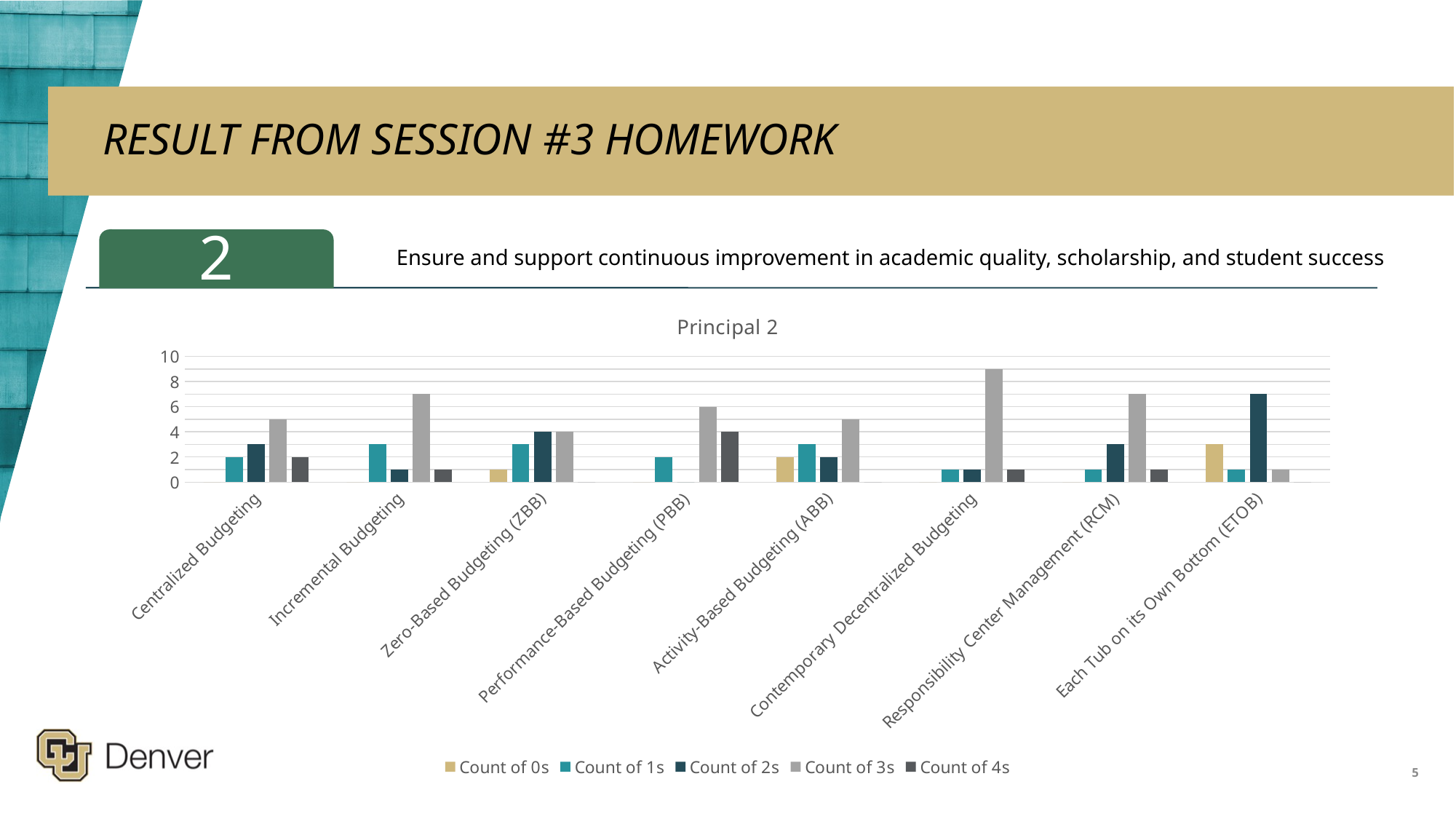
What kind of chart is shown on the slide? bar chart Is the Count of 3s value for Contemporary Decentralized Budgeting greater or less than 8? greater What is the Count of 1s value for Centralized Budgeting? 2 What is the Count of 3s value for Performance-Based Budgeting (PBB)? 6 Which category has the highest Count of 3s? Contemporary Decentralized Budgeting How many budgeting categories are shown on the x axis? 8 How many series does the legend list? 5 What is the Count of 2s value for Zero-Based Budgeting (ZBB)? 4 For Performance-Based Budgeting (PBB), what is the difference between the Count of 3s and the Count of 4s? 2 What is the Count of 0s value for Activity-Based Budgeting (ABB)? 2 What is the title of the chart? Principal 2 What is the Count of 4s value for Performance-Based Budgeting (PBB)? 4